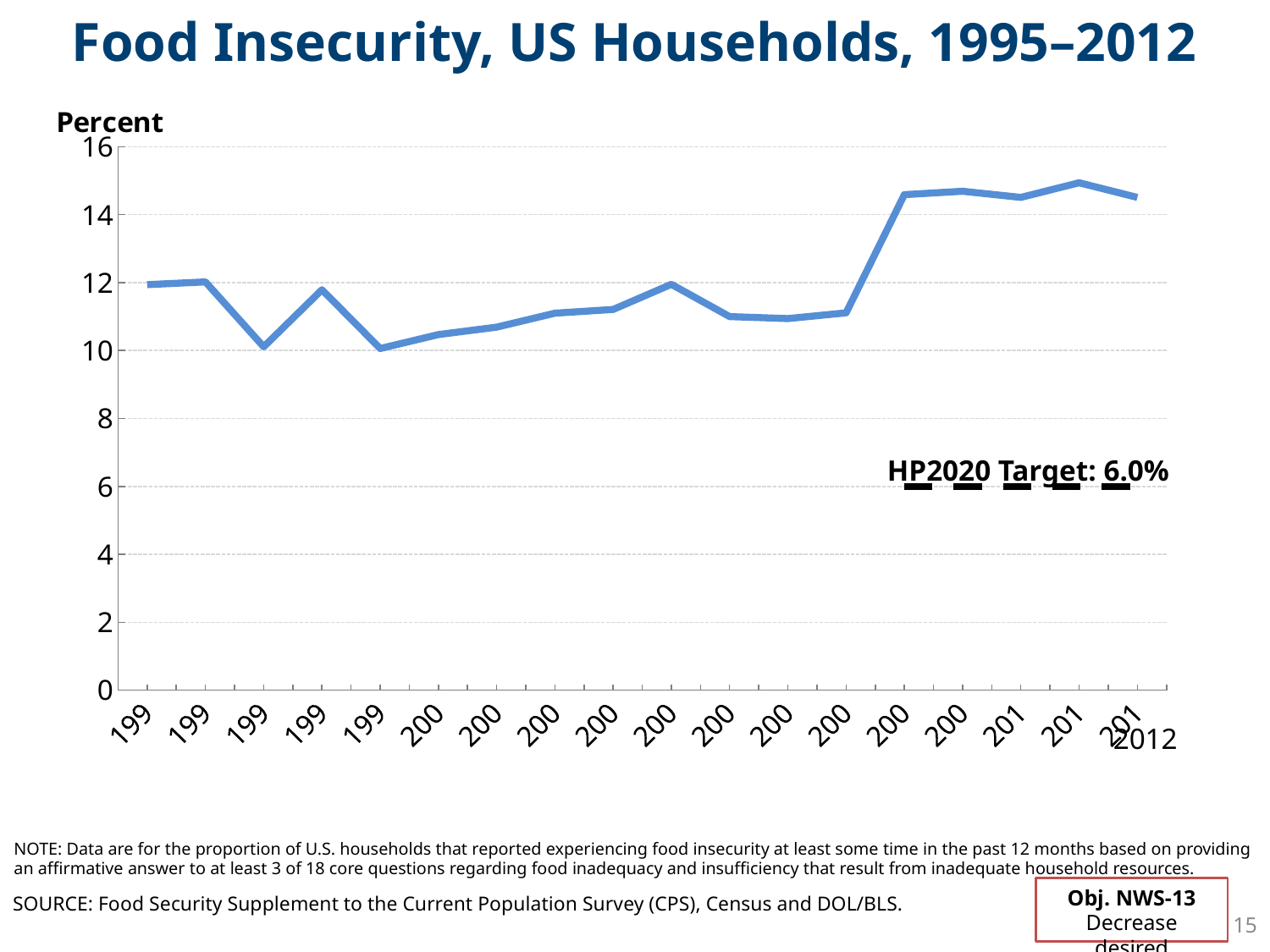
Which is larger, the value for 2012 or the HP2020 Target of 6.0%? the value for 2012 Are all plotted values above the HP2020 Target of 6.0%? yes What is the title of the chart? Food Insecurity, US Households, 1995–2012 How many years (data points) are plotted on the line? 18 What is the label on the y axis of the chart? Percent Is the value for the first year (1995) greater or less than 14? less Is the value for the first year (1995) greater or less than 10? greater What kind of chart is shown on the slide? line chart Overall, do the values rise or fall from 1995 to 2012? rise What is the HP2020 Target value shown on the chart? 6.0%